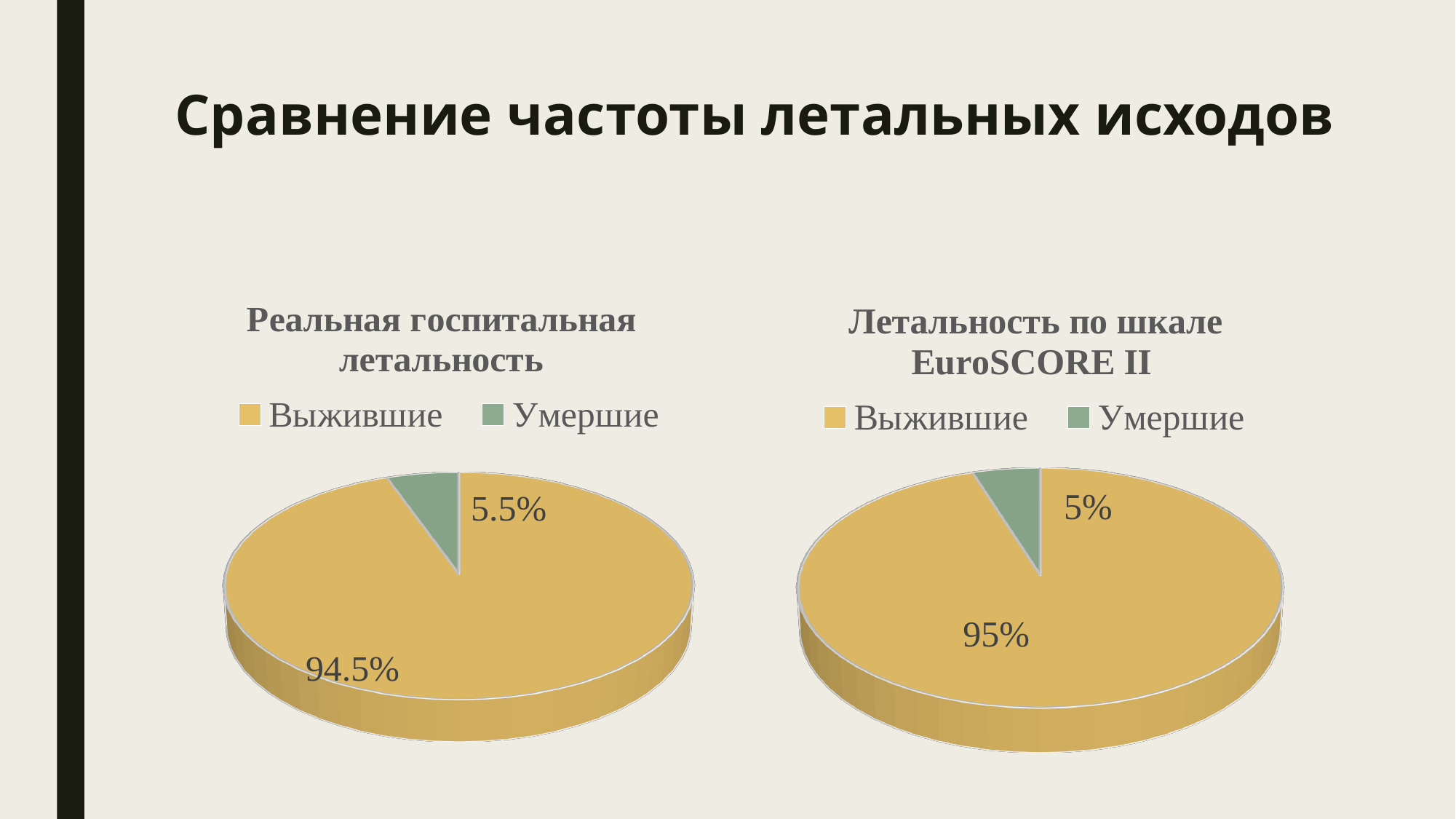
In the chart titled "Реальная госпитальная летальность", which category has the largest slice? Выжившие In the chart titled "Летальность по шкале EuroSCORE II", what colour is the Умершие slice? Green How many slices does the chart titled "Летальность по шкале EuroSCORE II" have? 2 In the chart titled "Реальная госпитальная летальность", what is the value for Умершие? 5.5% What kind of chart is the left chart, "Реальная госпитальная летальность"? Pie chart In the chart titled "Летальность по шкале EuroSCORE II", what is the value for Выжившие? 95% Which is larger: Умершие in "Реальная госпитальная летальность" or Умершие in "Летальность по шкале EuroSCORE II"? Умершие in "Реальная госпитальная летальность" In the chart titled "Летальность по шкале EuroSCORE II", which category has the smallest slice? Умершие How many entries does the legend of the chart titled "Реальная госпитальная летальность" list? 2 In the chart titled "Реальная госпитальная летальность", what is the value for Выжившие? 94.5% In the chart titled "Реальная госпитальная летальность", what is the difference between Выжившие and Умершие? 89% In the chart titled "Летальность по шкале EuroSCORE II", what is the value for Умершие? 5%